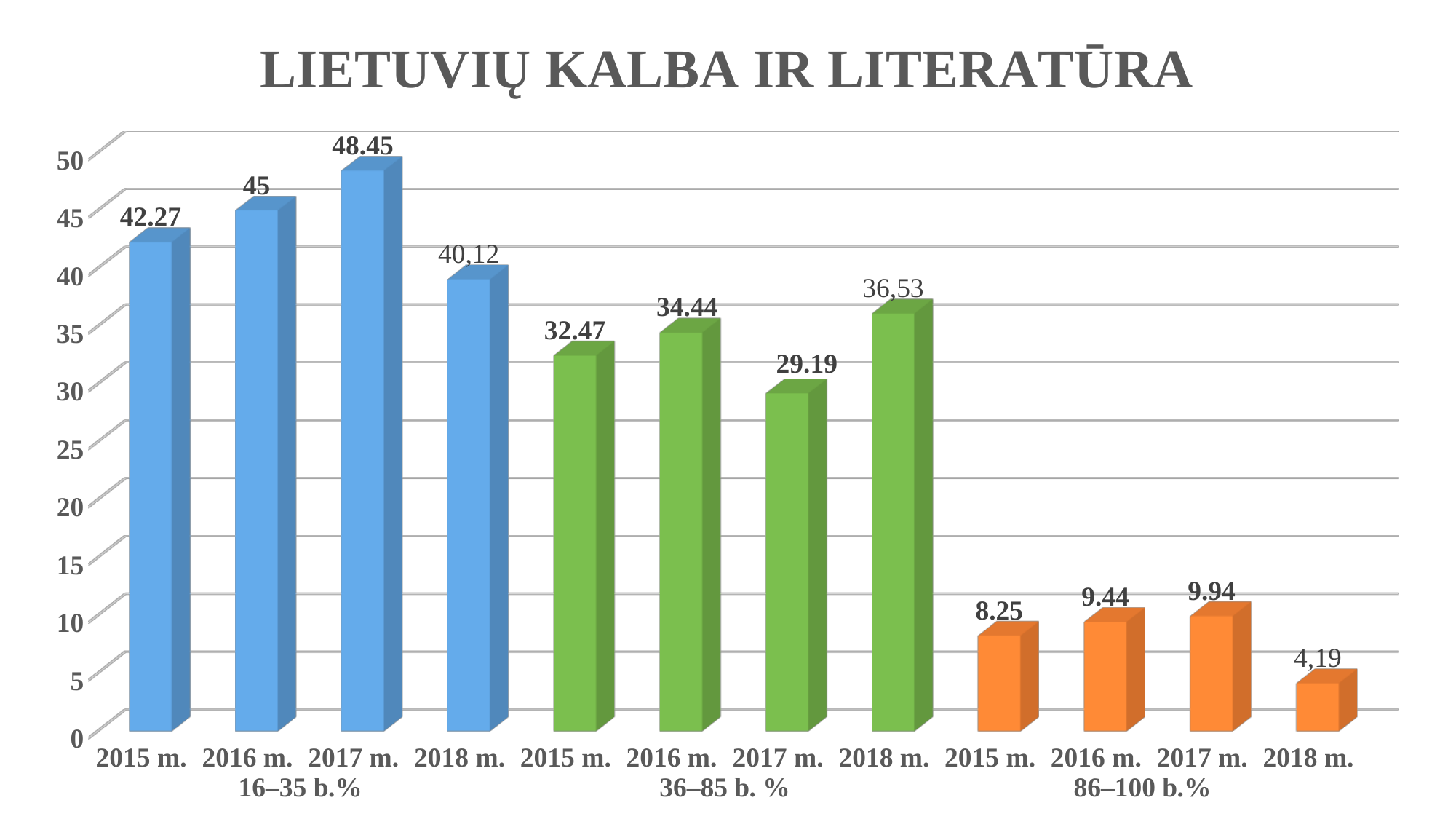
What is the value for 2017 m. in the 16–35 b.% group? 48.45 Which year has the lowest value in the 86–100 b.% group? 2018 m. Which is larger: the 2016 m. value in the 36–85 b. % group or the 2015 m. value in the 36–85 b. % group? 2016 m. in the 36–85 b. % group Is the value for 2018 m. in the 16–35 b.% group greater or less than 35? greater What is the difference between the 2017 m. and 2015 m. values in the 16–35 b.% group? 6.18 What is the value for 2015 m. in the 86–100 b.% group? 8.25 How many bars are plotted on the chart? 12 What kind of chart is shown on the slide? Bar chart Which year has the lowest value in the 36–85 b. % group? 2017 m. What is the value for 2018 m. in the 36–85 b. % group? 36,53 Which year has the highest value in the 16–35 b.% group? 2017 m. What is the difference between the 2017 m. and 2015 m. values in the 86–100 b.% group? 1.69